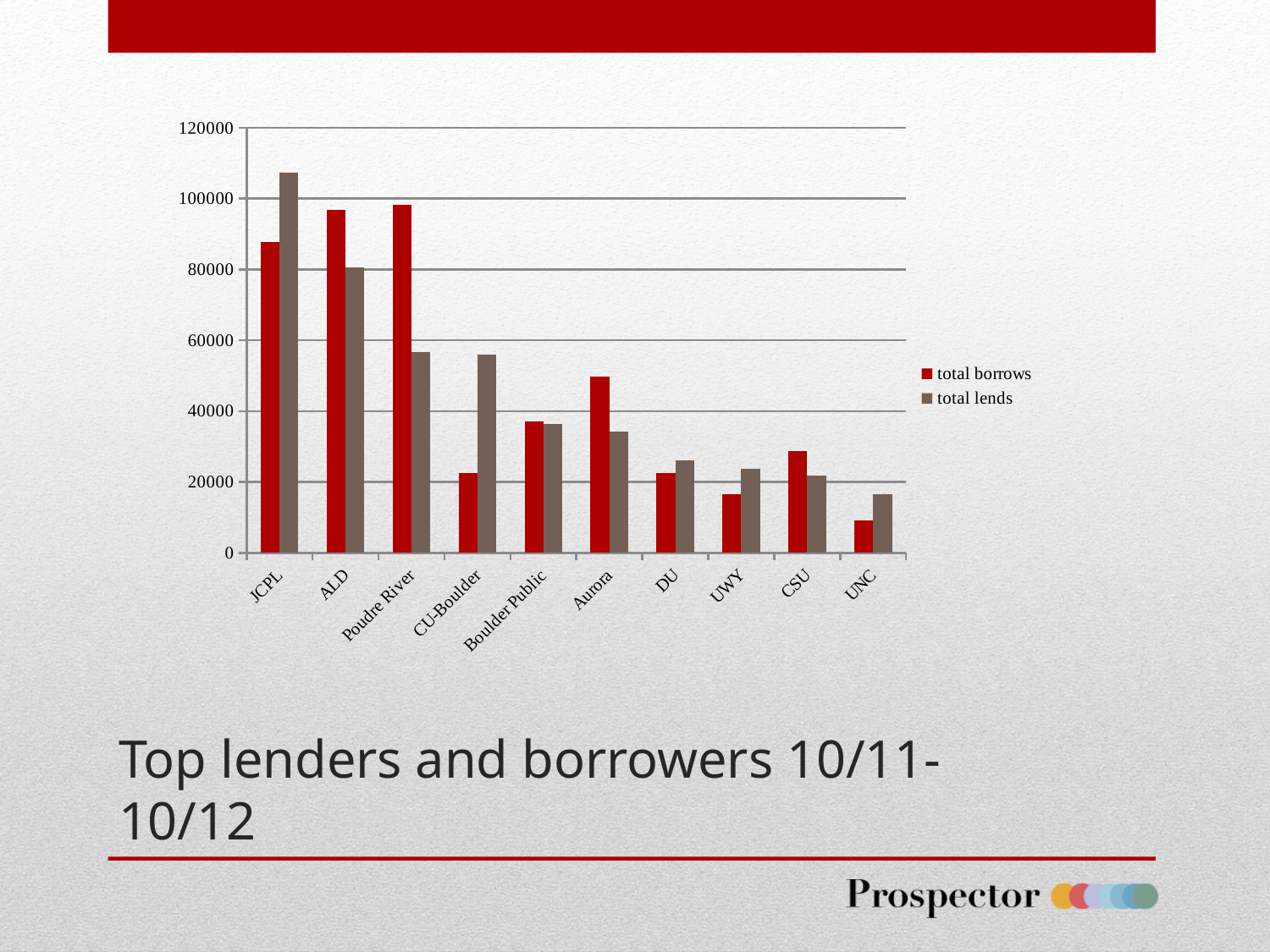
For Aurora, which is larger: total borrows or total lends? total borrows Which library has the highest total lends? JCPL Which library has the lowest total lends? UNC Is the total borrows value for Aurora greater or less than 40000? greater What kind of chart is shown on the slide? bar chart Is the total lends value for JCPL greater or less than 100000? greater How many libraries are shown on the x axis of the chart? 10 Which library has the lowest total borrows? UNC How many series does the legend list? 2 Is the total borrows value for CU-Boulder greater or less than 40000? less Which series is shown in red in the chart? total borrows For JCPL, which is larger: total borrows or total lends? total lends